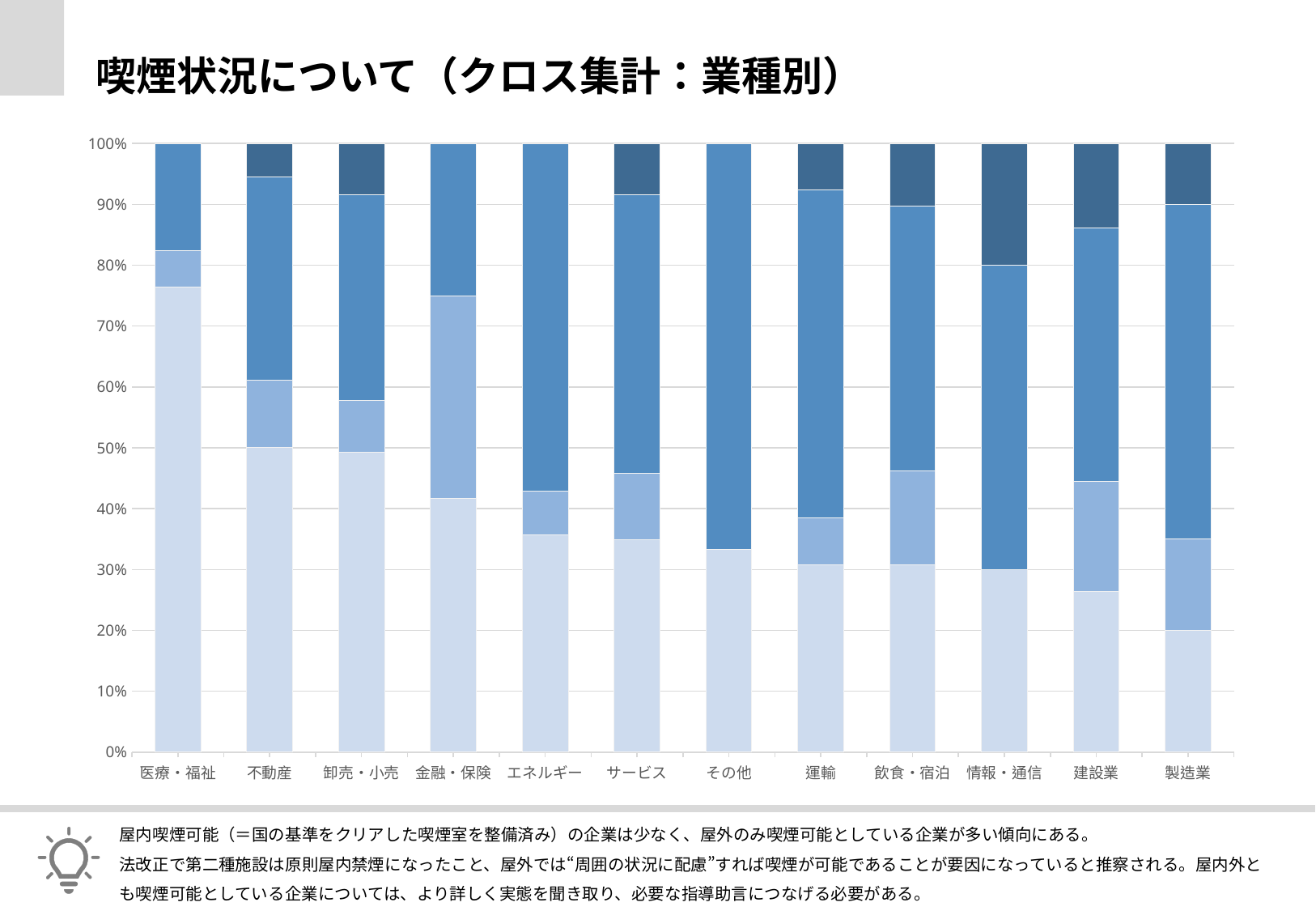
Is the bottom (lightest blue) segment for 建設業 greater or less than 30%? less How many industry categories are shown along the x axis? 12 Is the bottom (lightest blue) segment for 医療・福祉 greater or less than 70%? greater Which category has the largest top (darkest blue) segment? 情報・通信 Which has the larger bottom (lightest blue) segment, 不動産 or 製造業? 不動産 Which category has the largest bottom (lightest blue) segment? 医療・福祉 What is the title of the slide containing the chart? 喫煙状況について（クロス集計：業種別） Is the bottom (lightest blue) segment for 製造業 greater or less than 30%? less What kind of chart is shown on the slide? Stacked bar chart What is the maximum value shown on the vertical axis? 100% Which category has the smallest bottom (lightest blue) segment? 製造業